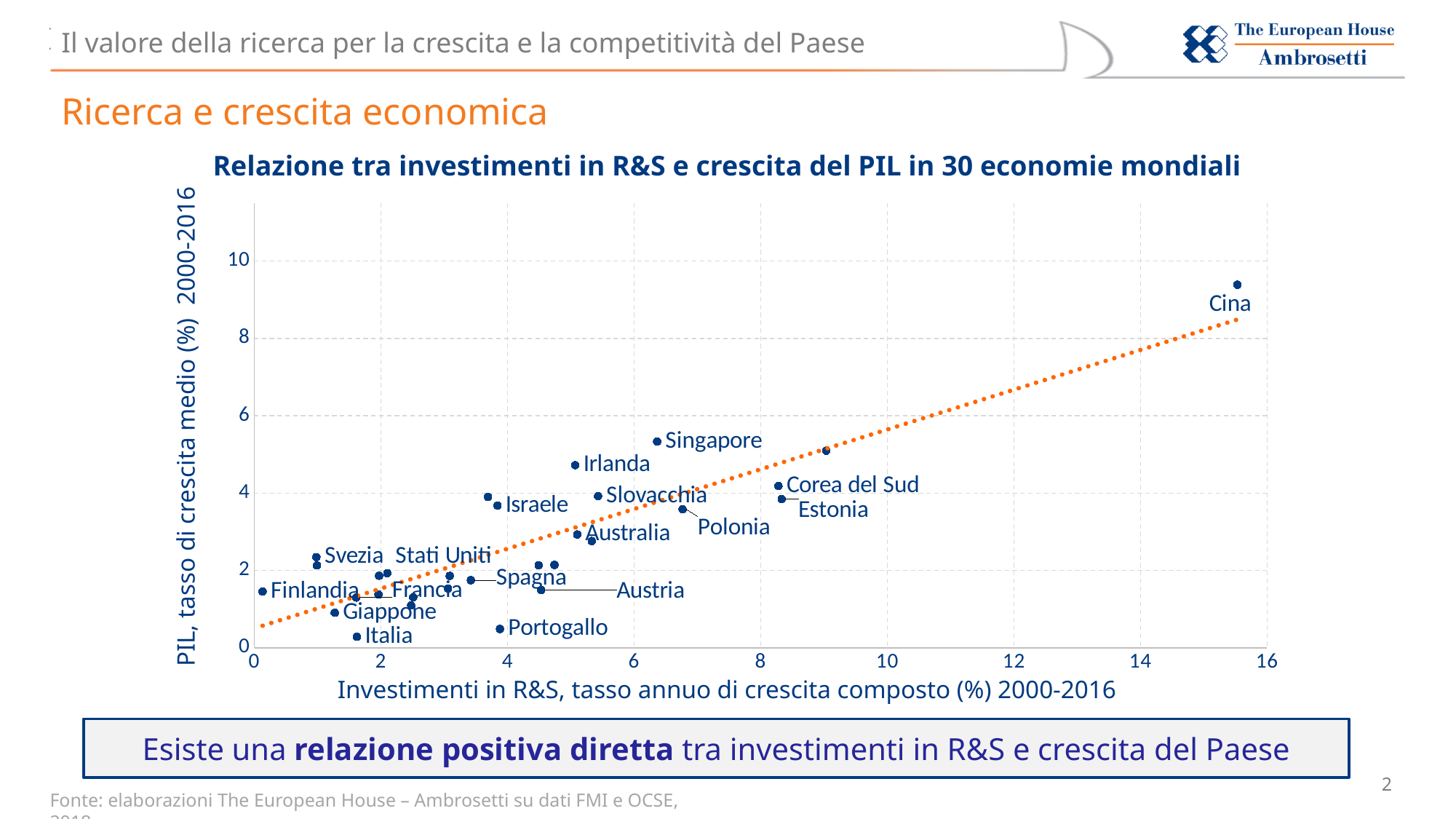
Is the average GDP growth value for Italia greater or less than 2? less Which has the higher average GDP growth, Singapore or Irlanda? Singapore Is the average GDP growth value for Singapore greater or less than 4? greater Do the GDP growth values generally rise or fall as R&S investment growth increases along the x axis? rise Which country has the highest R&S investment growth rate in the chart? Cina Which country has the highest average GDP growth (PIL) in the chart? Cina What kind of chart is shown on the slide? Scatter chart Is the average GDP growth value for Cina greater or less than 8? greater What is the title of the chart? Relazione tra investimenti in R&S e crescita del PIL in 30 economie mondiali What is the label of the x axis? Investimenti in R&S, tasso annuo di crescita composto (%) 2000-2016